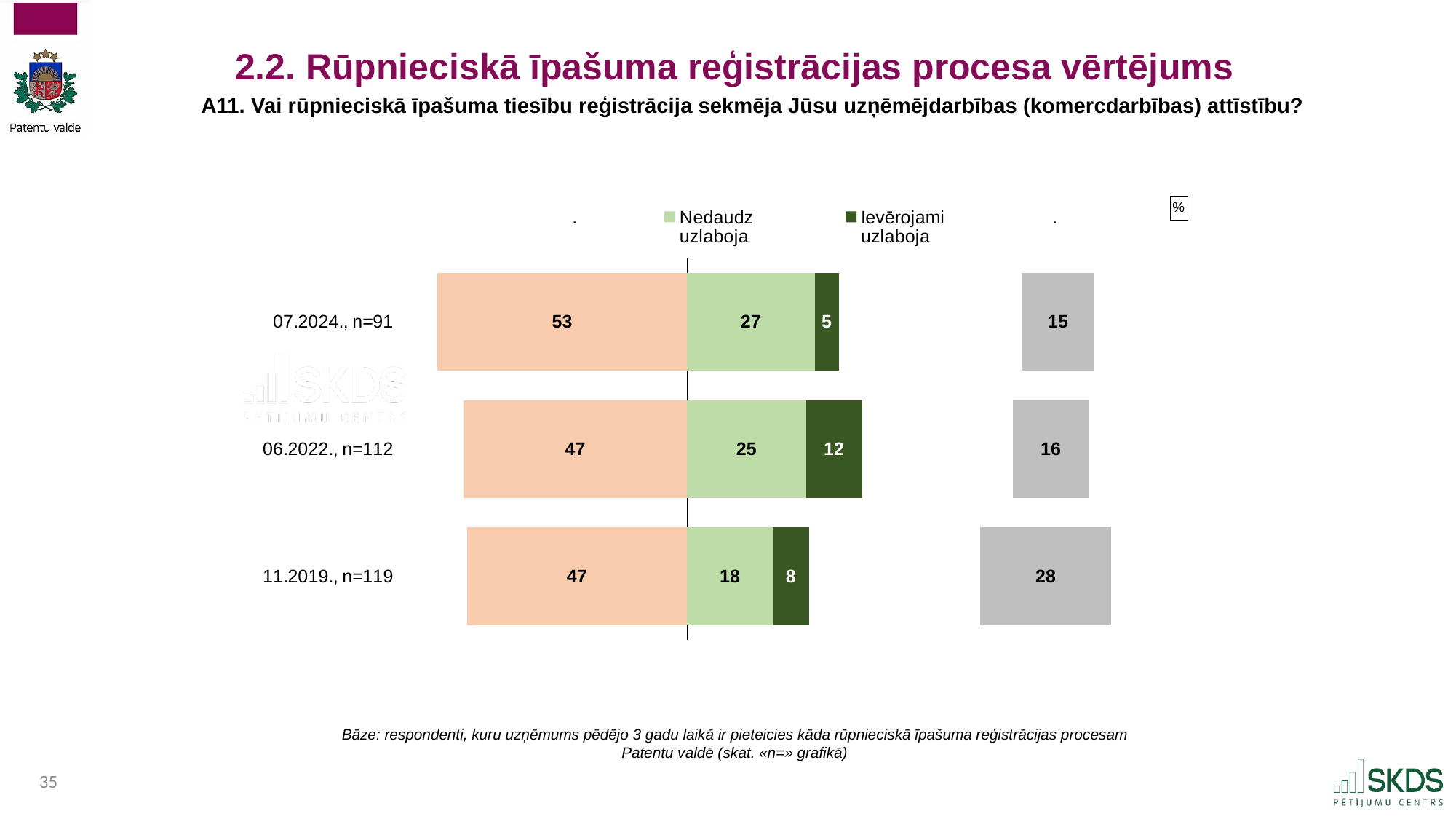
What is the value of "Ievērojami uzlaboja" for 11.2019., n=119? 8 What kind of chart is shown on the slide? Stacked bar chart What colour represents "Ievērojami uzlaboja" in the chart? Dark green Which survey wave has the highest value for "Ievērojami uzlaboja"? 06.2022., n=112 Does the "Nedaudz uzlaboja" value rise or fall from 11.2019., n=119 to 07.2024., n=91? Rises Which has a larger "Nedaudz uzlaboja" value: 06.2022., n=112 or 11.2019., n=119? 06.2022., n=112 What is the value of "Nedaudz uzlaboja" for 11.2019., n=119? 18 Which survey wave has the lowest value for "Ievērojami uzlaboja"? 07.2024., n=91 What is the value of "Ievērojami uzlaboja" for 06.2022., n=112? 12 How many survey waves are shown in the chart? 3 What is the difference between the "Nedaudz uzlaboja" values for 07.2024., n=91 and 11.2019., n=119? 9 What is the value of "Nedaudz uzlaboja" for 07.2024., n=91? 27